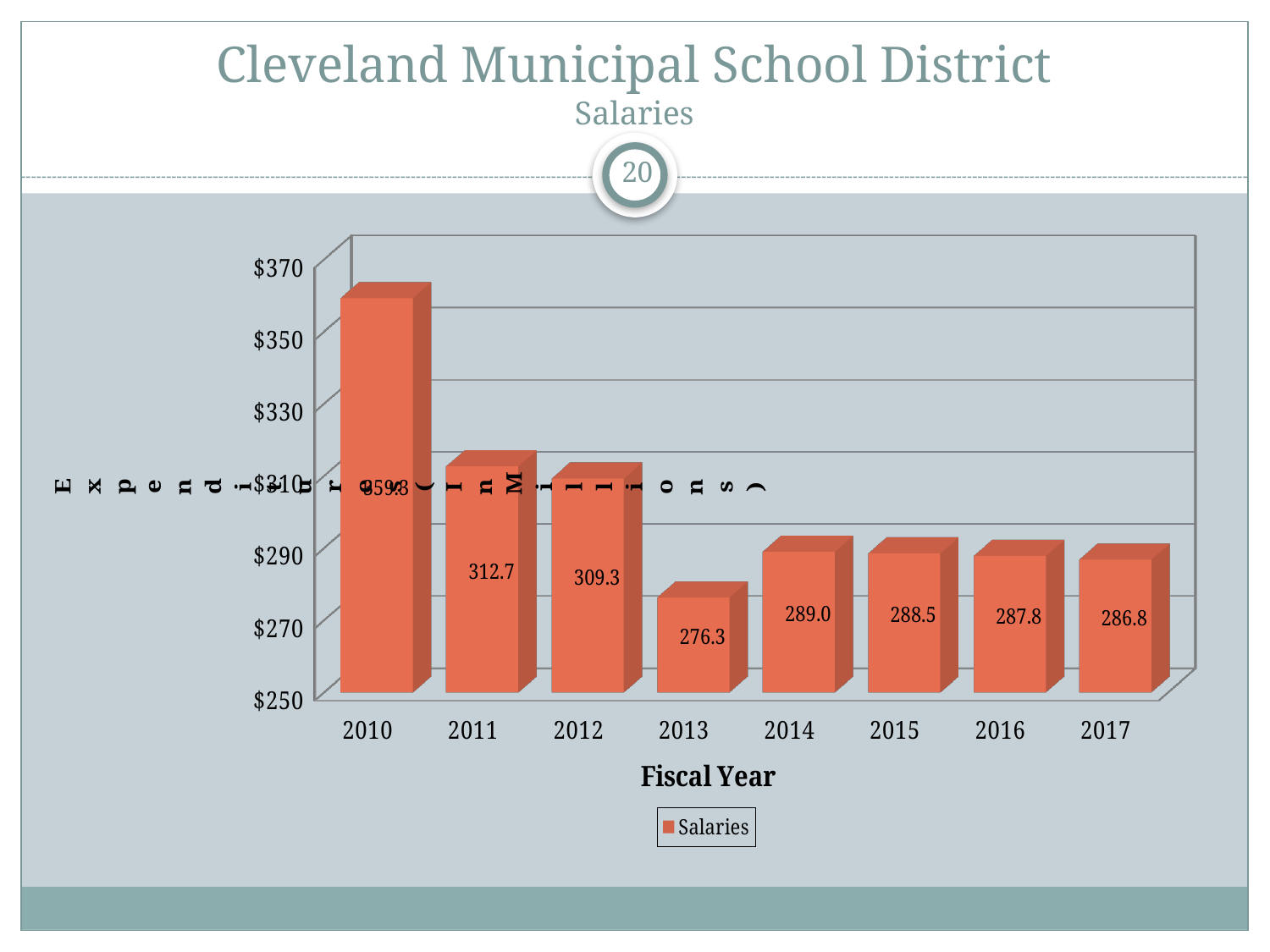
What is the value for 2013? 276.3 What is the value for 2017? 286.8 How many series does the legend list? 1 Which is larger, the value for 2012 or the value for 2014? 2012 What is the difference between the values for 2014 and 2017? 2.2 What is the difference between the values for 2011 and 2012? 3.4 Is the value for 2010 greater or less than $350? greater What kind of chart is shown on the slide? bar chart What is the value for 2011? 312.7 Which fiscal year has the lowest salaries value? 2013 How many fiscal years are shown on the x axis? 8 Which fiscal year has the highest salaries value? 2010